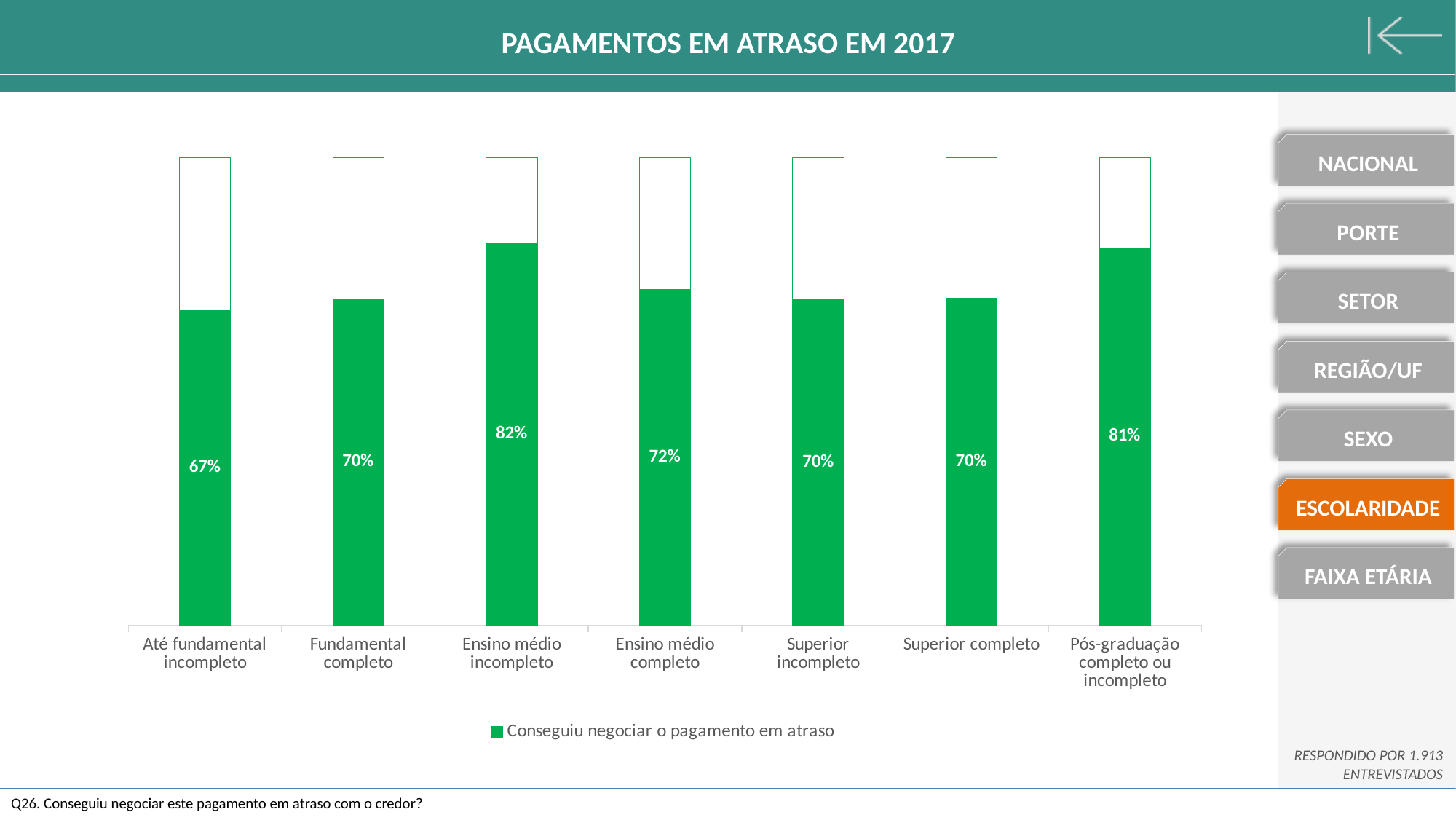
What kind of chart is shown on the slide? bar chart Which category has the highest value? Ensino médio incompleto What is the value for Ensino médio incompleto? 82% What is the value for Pós-graduação completo ou incompleto? 81% What is the value for Ensino médio completo? 72% How many series does the legend list? 1 What is the value for Até fundamental incompleto? 67% Which category has the lowest value? Até fundamental incompleto How many categories are shown on the x axis? 7 What is the legend entry for the green bars? Conseguiu negociar o pagamento em atraso Which is larger, the value for Ensino médio completo or the value for Superior incompleto? Ensino médio completo What is the difference between the values for Ensino médio incompleto and Até fundamental incompleto? 15%